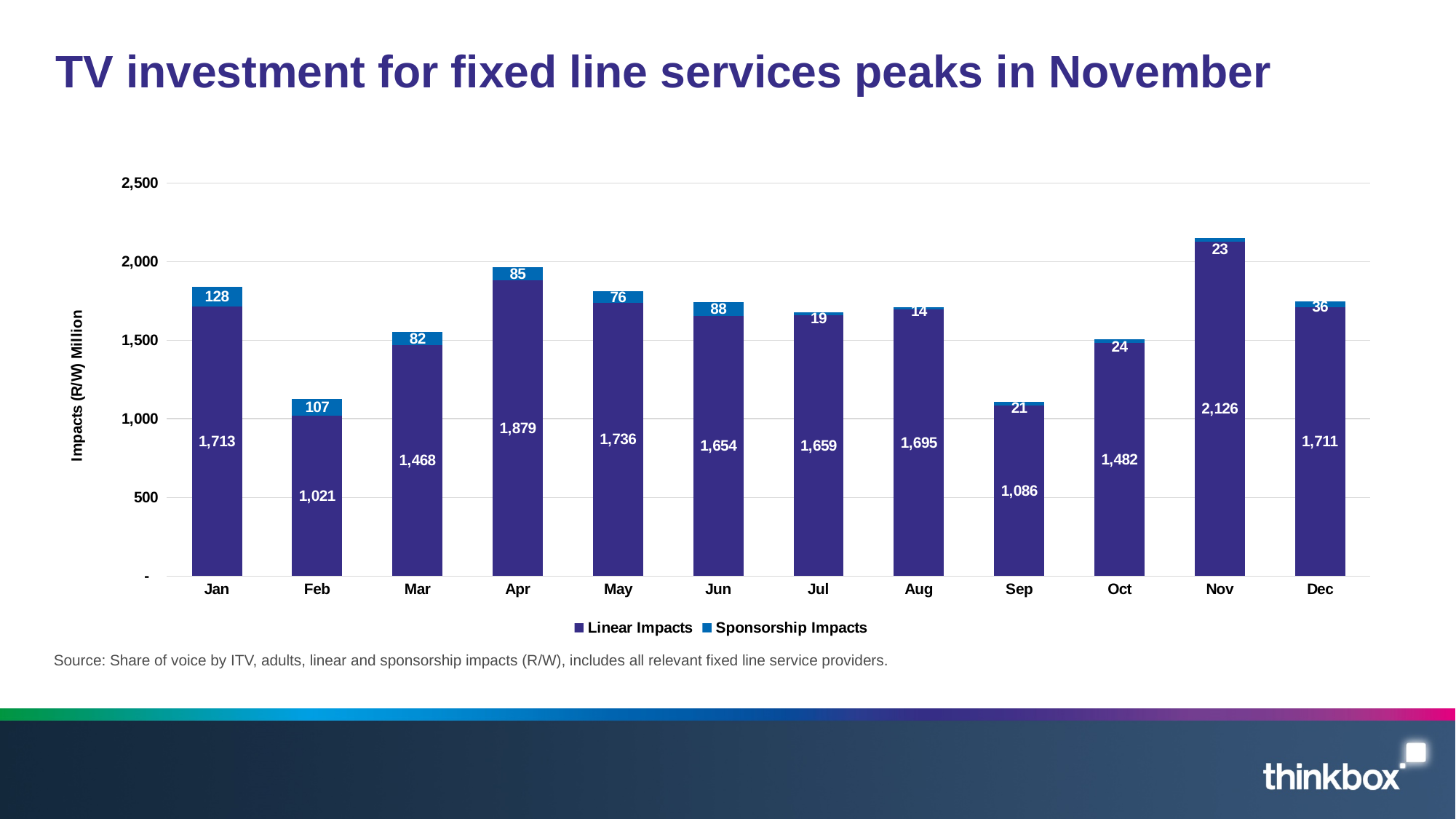
What is the Linear Impacts value for September? 1,086 What is the difference between the Linear Impacts values for November and February? 1,105 Which month has the highest Linear Impacts value? Nov What is the total of the stacked bar for January (Linear Impacts plus Sponsorship Impacts)? 1,841 Which month has the lowest Linear Impacts value? Feb Which is larger, the Linear Impacts value for April or for May? Apr What is the Sponsorship Impacts value for January? 128 How many series does the legend list? 2 What is the Linear Impacts value for November? 2,126 How many months are shown on the x axis? 12 Which month has the lowest Sponsorship Impacts value? Aug What kind of chart is shown on the slide? Stacked bar chart